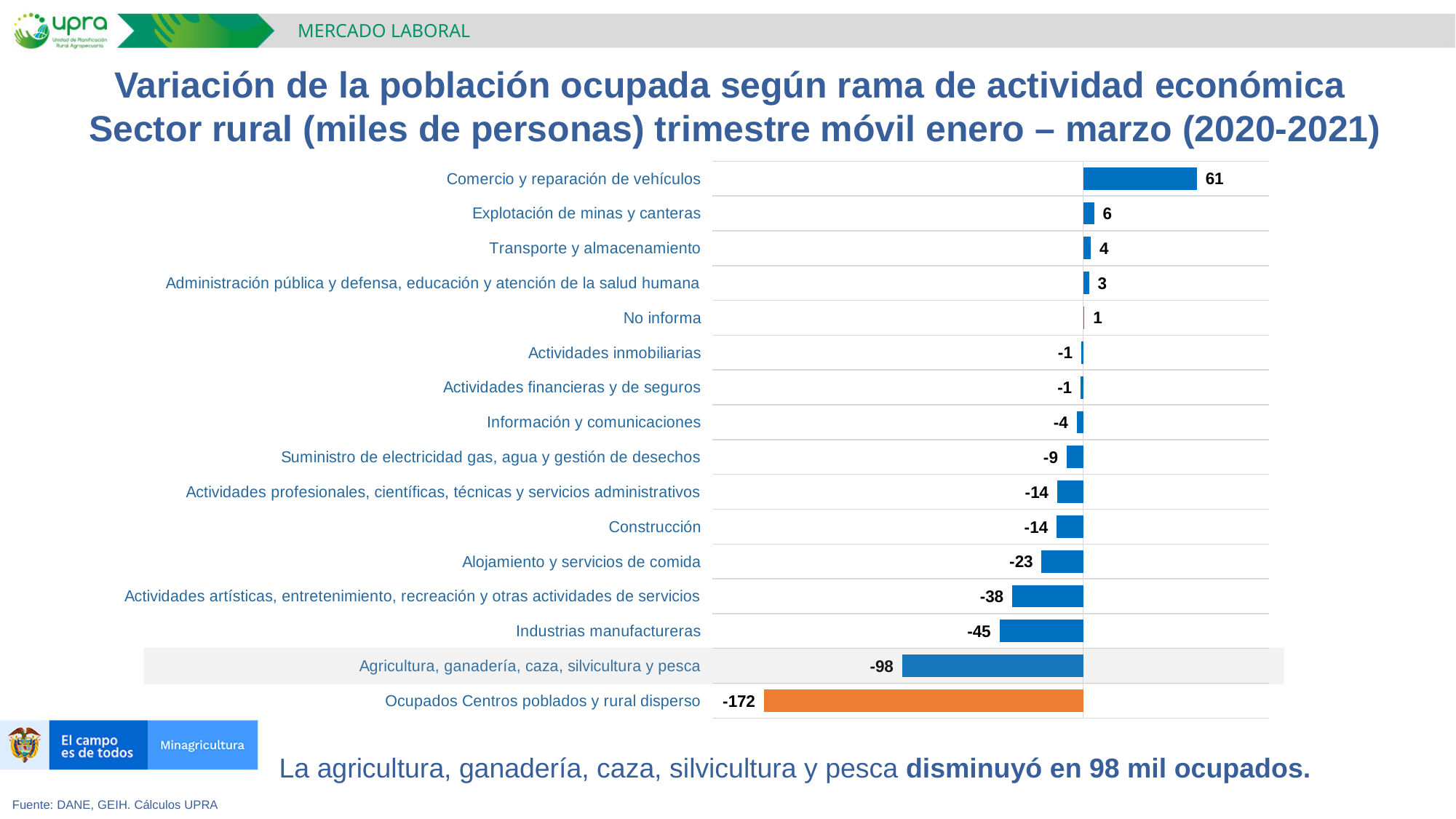
What is the value for Comercio y reparación de vehículos? 61 What colour is the bar for Ocupados Centros poblados y rural disperso? Orange What is the value for Alojamiento y servicios de comida? -23 Which category has the lowest value? Ocupados Centros poblados y rural disperso How many categories are shown in the chart? 16 What is the value for Industrias manufactureras? -45 Which is larger, the value for Construcción or the value for Actividades artísticas, entretenimiento, recreación y otras actividades de servicios? Construcción What kind of chart is shown on the slide? Bar chart What is the value for Agricultura, ganadería, caza, silvicultura y pesca? -98 What is the difference between the values for Comercio y reparación de vehículos and Explotación de minas y canteras? 55 What is the value for Ocupados Centros poblados y rural disperso? -172 Which category has the highest value? Comercio y reparación de vehículos